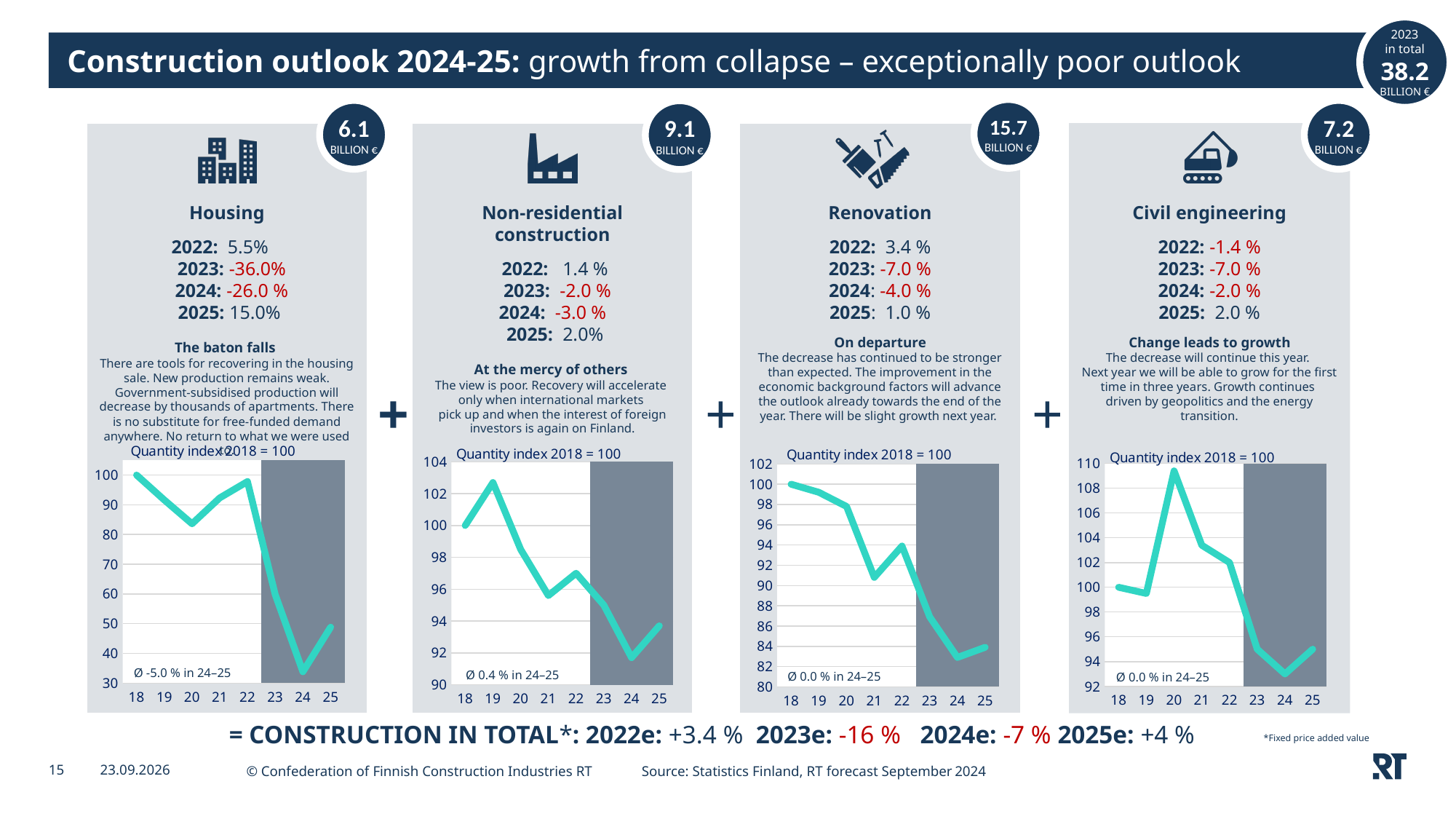
In the Housing chart, what is the quantity index value for 2018? 100 In the Housing chart, does the quantity index rise or fall from 2022 to 2024? fall In the Civil engineering chart, is the value for 2020 greater or less than 108? greater What kind of chart is used in the Housing panel? line chart In the Renovation chart, is the value for 2024 greater or less than 86? less How many years are plotted on the x axis of the Renovation chart? 8 In the Non-residential construction chart, is the value for 2019 greater or less than 102? greater In the Housing chart, which year has the lowest quantity index? 2024 In the Civil engineering chart, which year has the highest quantity index? 2020 In the Non-residential construction chart, which year has the highest quantity index? 2019 In the Housing chart, which is larger, the value for 2020 or the value for 2022? 2022